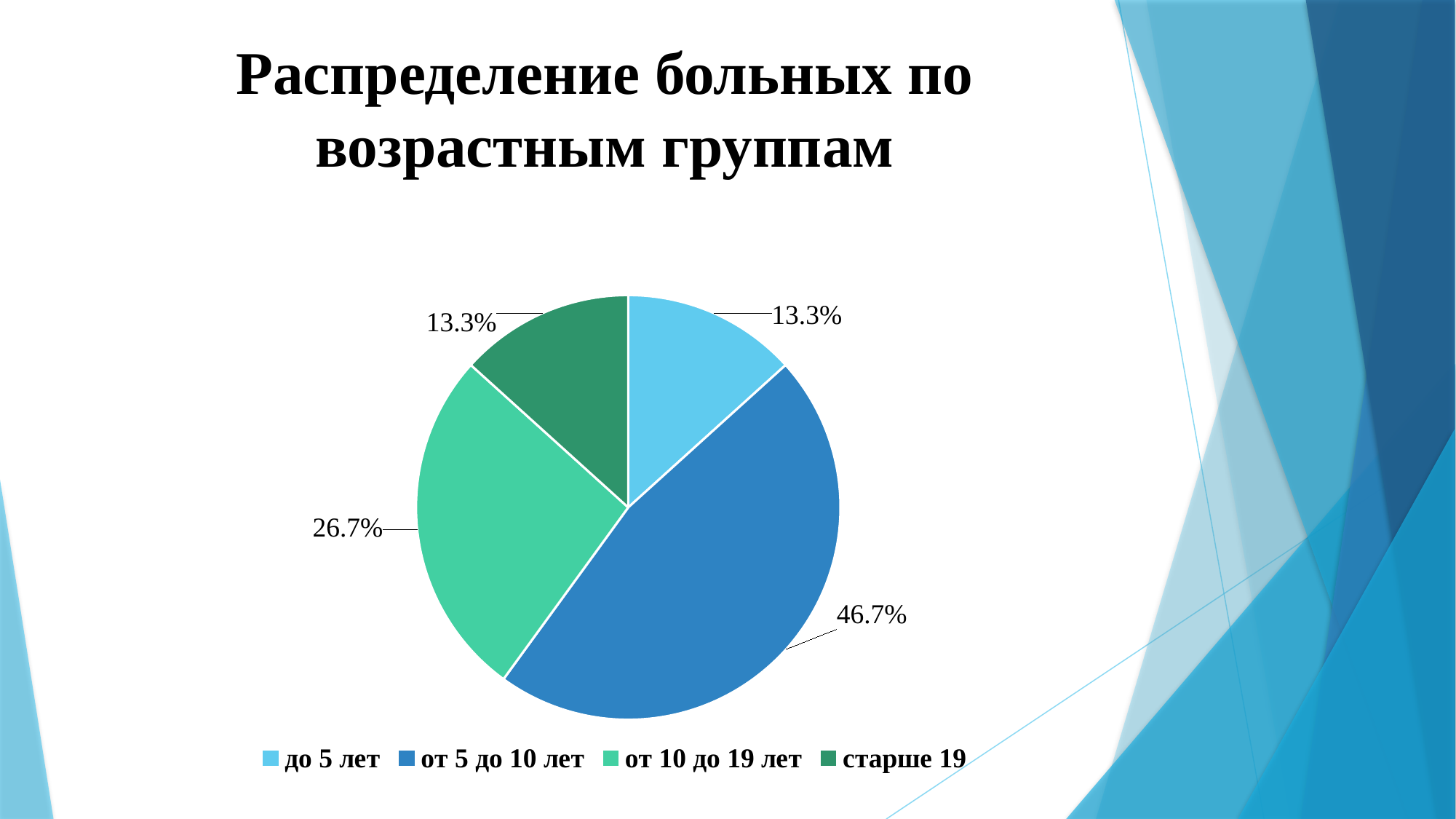
What is the title of the slide? Распределение больных по возрастным группам What type of chart is shown on the slide? Pie chart What share of the pie does the slice for "от 10 до 19 лет" represent? 26.7% By how many percentage points does the "от 10 до 19 лет" slice exceed the "до 5 лет" slice? 13.4 percentage points What share of the pie does the slice for "старше 19" represent? 13.3% What share of the pie does the slice for "от 5 до 10 лет" represent? 46.7% Which age group has the largest slice of the pie? от 5 до 10 лет Which is larger: the slice for "от 5 до 10 лет" or the slice for "старше 19"? от 5 до 10 лет How many age groups (slices) are shown in the pie chart? 4 By how many percentage points does the "от 5 до 10 лет" slice exceed the "от 10 до 19 лет" slice? 20.0 percentage points Which is larger: the slice for "от 10 до 19 лет" or the slice for "до 5 лет"? от 10 до 19 лет What share of the pie does the slice for "до 5 лет" represent? 13.3%